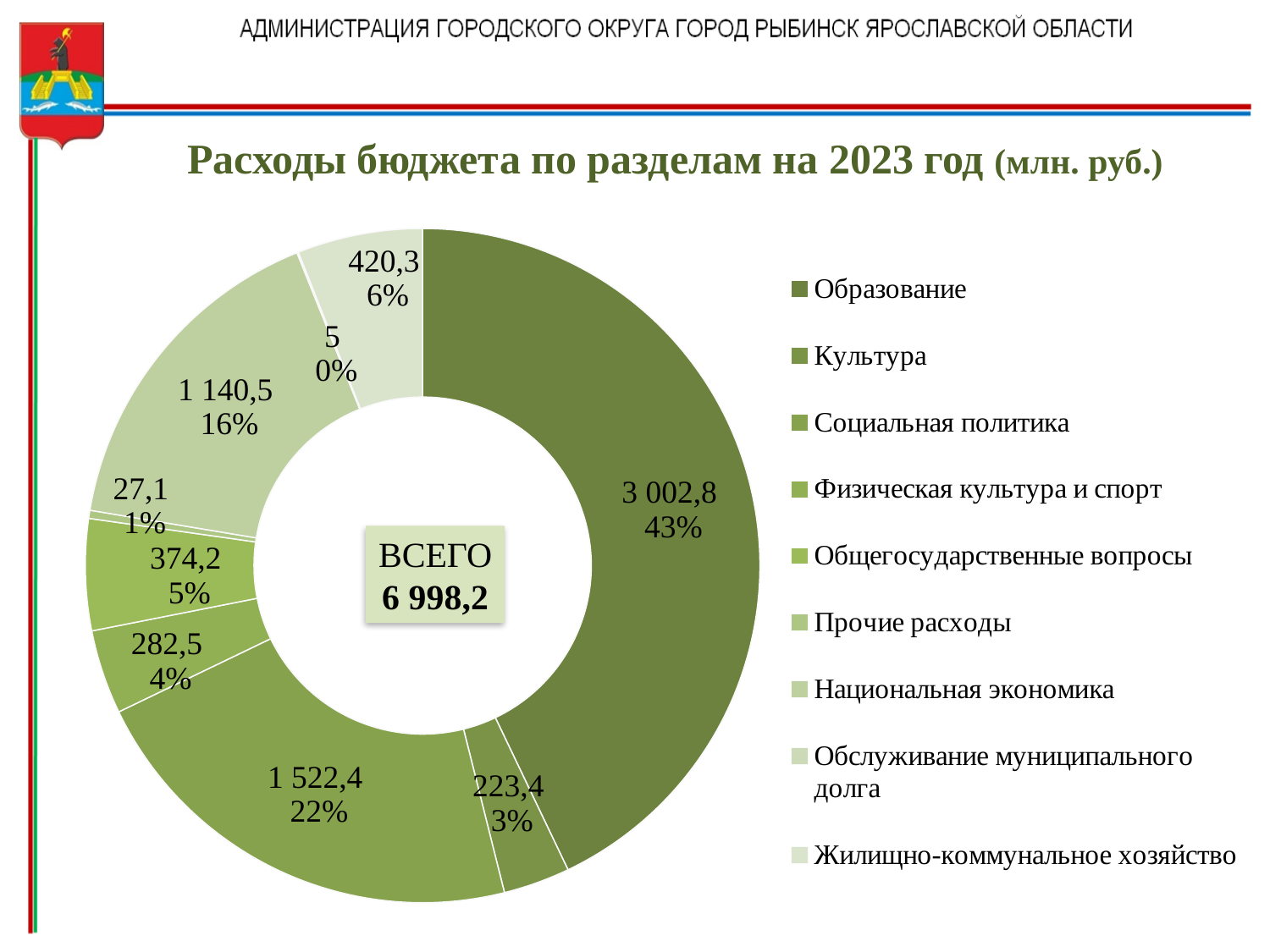
What is the value for Социальная политика? 1 522,4 What is the difference between the values for Образование and Социальная политика? 1 480,4 Which category has the lowest value? Обслуживание муниципального долга Which is larger, the value for Общегосударственные вопросы or Физическая культура и спорт? Общегосударственные вопросы What is the value for Жилищно-коммунальное хозяйство? 420,3 What share of the total does Национальная экономика account for? 16% How many categories does the legend list? 9 What type of chart is shown on the slide? Doughnut (pie) chart What is the value for Национальная экономика? 1 140,5 Which category has the highest value? Образование What is the value for Образование? 3 002,8 What share of the total does Образование account for? 43%